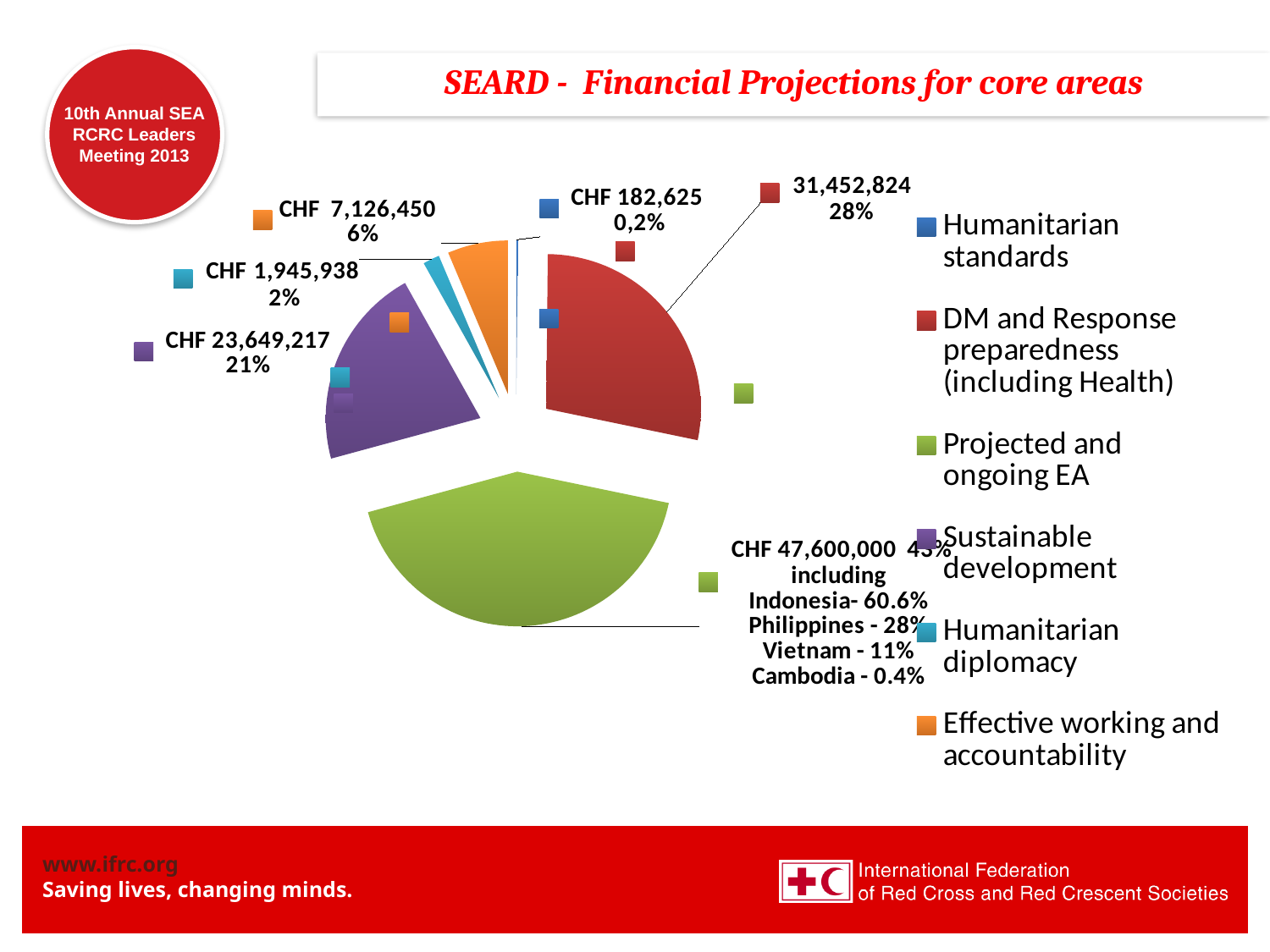
What is the value for Humanitarian diplomacy? CHF 1,945,938 What is the value for Sustainable development? CHF 23,649,217 What kind of chart is shown on the slide? pie chart How many categories does the legend of the pie chart list? 6 What is the value for Humanitarian standards? CHF 182,625 Which category has the largest slice of the pie? Projected and ongoing EA What share of the pie does DM and Response preparedness (including Health) represent? 28% Which is larger, the value for Effective working and accountability or the value for Humanitarian diplomacy? Effective working and accountability What is the value for Effective working and accountability? CHF 7,126,450 What is the difference between the values for DM and Response preparedness (including Health) and Sustainable development? 7,803,607 What share of the pie does Sustainable development represent? 21% Which category has the smallest slice of the pie? Humanitarian standards